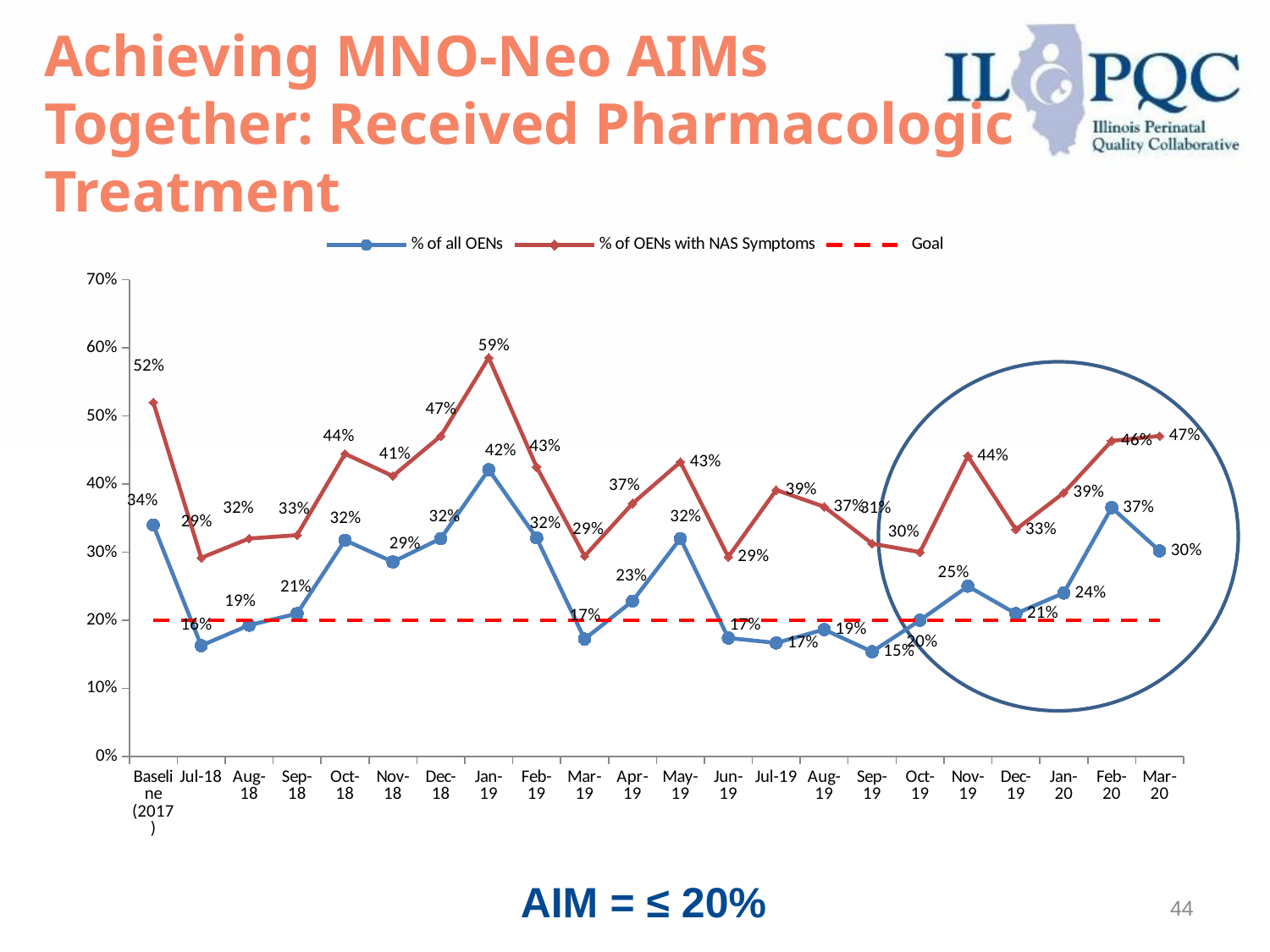
What is the '% of OENs with NAS Symptoms' value at Baseline (2017)? 52% What is the lowest value of the '% of all OENs' series, and in which month does it occur? 15% in Sep-19 What kind of chart is shown on the slide? Line chart What is the value of '% of all OENs' for Mar-20? 30% What is the value of '% of OENs with NAS Symptoms' for Nov-19? 44% For '% of OENs with NAS Symptoms', which is larger: the value for Oct-18 or the value for Dec-18? Dec-18 At what value is the dashed Goal line drawn? 20% How many entries does the chart legend list? 3 In Jan-19, what is the difference between '% of OENs with NAS Symptoms' and '% of all OENs'? 17 percentage points In which month does the '% of OENs with NAS Symptoms' series reach its highest value? Jan-19 How many time points are plotted along the x axis, including the Baseline? 22 What is the value of '% of all OENs' for Feb-20? 37%